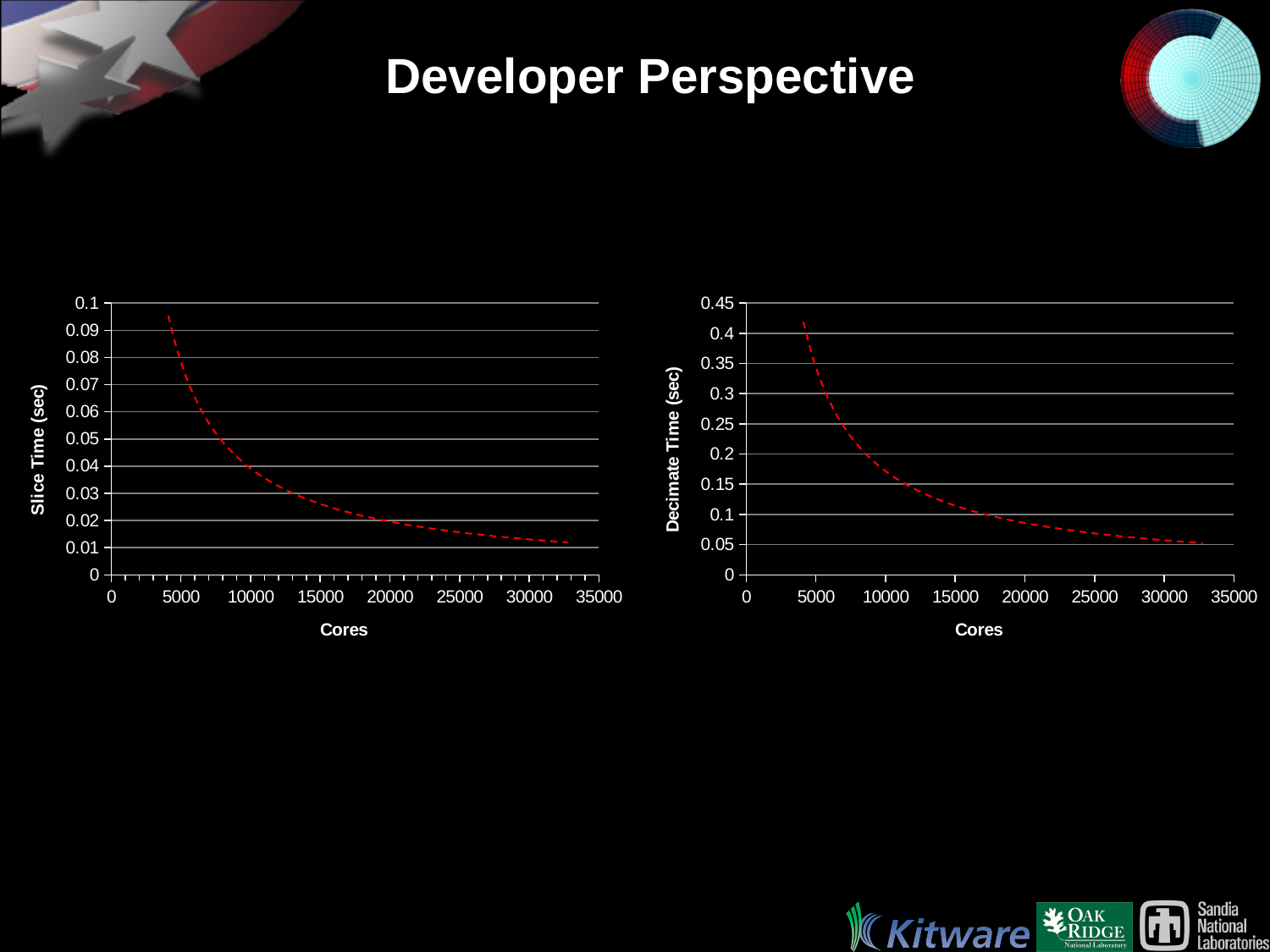
In the right chart, is the decimate time at 30000 cores greater or less than 0.1 sec? less In the left chart, is the slice time at 5000 cores greater or less than 0.05 sec? greater What is the y-axis label of the right chart? Decimate Time (sec) In the left chart, does the slice time rise or fall as the number of cores increases? fall What kind of chart is the right chart (Decimate Time vs Cores)? line chart In the right chart, is the decimate time at 5000 cores greater or less than 0.2 sec? greater What is the x-axis label shared by both charts? Cores In the right chart, does the decimate time rise or fall as the number of cores increases? fall What kind of chart is the left chart (Slice Time vs Cores)? line chart